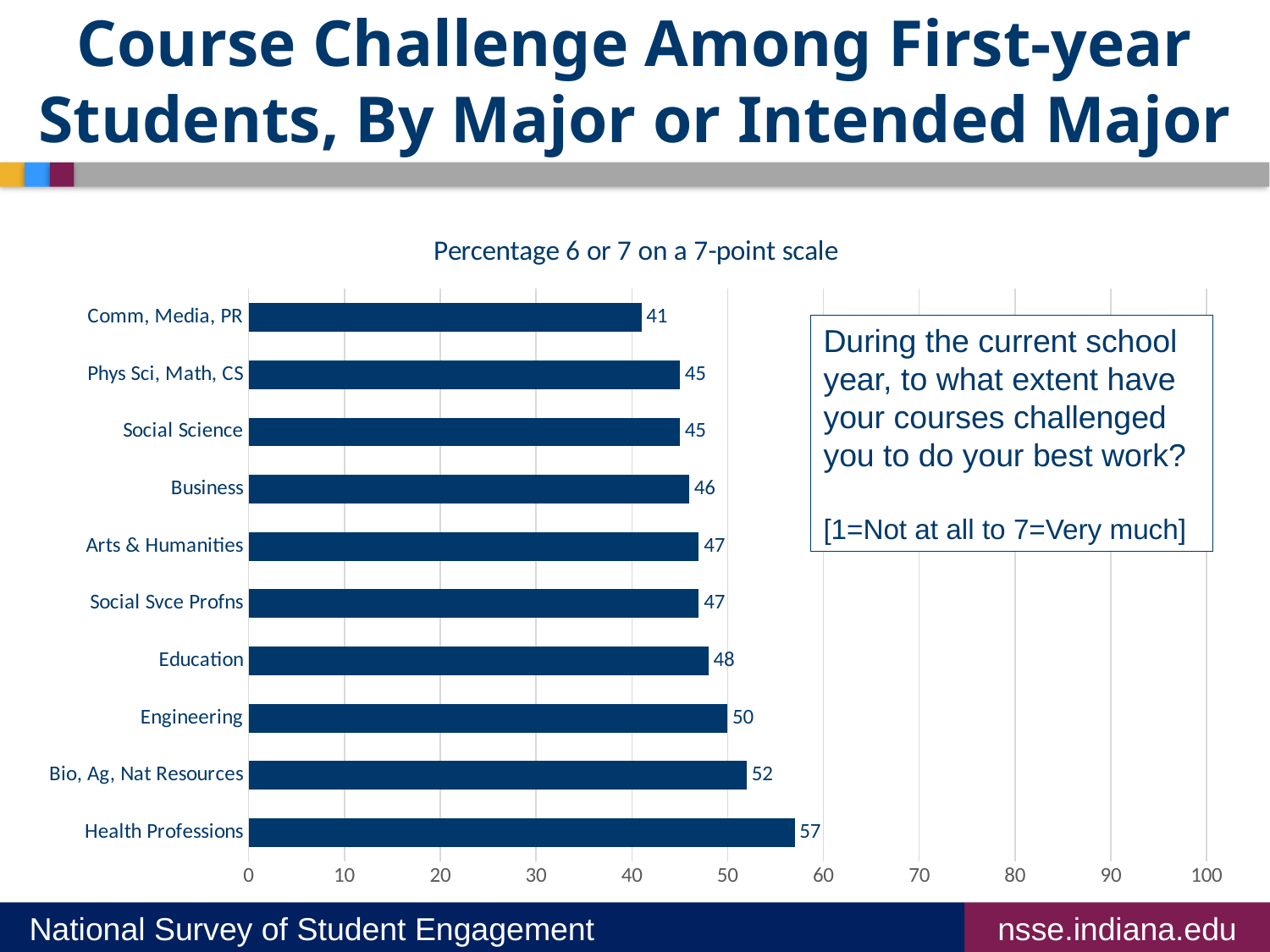
Which major has the highest percentage? Health Professions What kind of chart is shown on the slide? bar chart Which is larger, the value for Business or the value for Engineering? Engineering What is the value for Health Professions? 57 What is the value for Engineering? 50 What is the difference between the values for Bio, Ag, Nat Resources and Education? 4 What is the subtitle shown above the chart? Percentage 6 or 7 on a 7-point scale What is the value for Comm, Media, PR? 41 How many majors are shown in the chart? 10 What is the difference between the values for Health Professions and Comm, Media, PR? 16 Which major has the lowest percentage? Comm, Media, PR Is the value for Health Professions greater or less than 50? greater